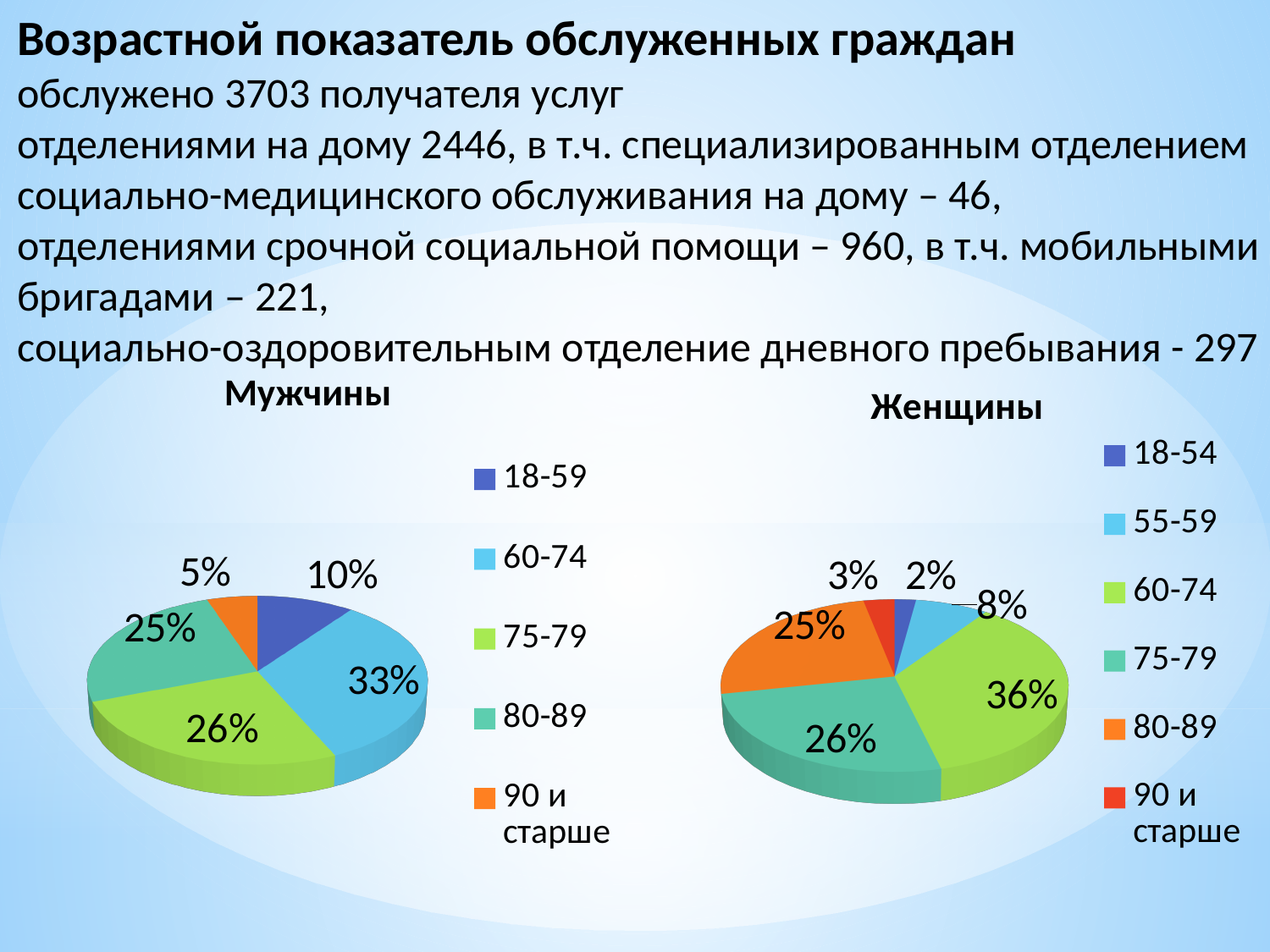
How many entries does the legend of the "Мужчины" pie chart list? 5 In the "Мужчины" pie chart, what is the difference between the shares for 60-74 and 18-59? 23% In the "Женщины" pie chart, which age group has the smallest share? 18-54 In the "Женщины" pie chart, what colour is the slice for "90 и старше"? Red In the "Мужчины" pie chart, what share is shown for the 60-74 age group? 33% In the "Женщины" pie chart, what share is shown for the 60-74 age group? 36% How many slices does the "Женщины" pie chart have? 6 In the "Женщины" pie chart, which is larger: the share for 75-79 or the share for 80-89? 75-79 In the "Женщины" pie chart, what share is shown for the 55-59 age group? 8% What type of chart is used for "Мужчины" and "Женщины"? Pie chart In the "Мужчины" pie chart, which age group has the largest share? 60-74 In the "Мужчины" pie chart, what share is shown for the "90 и старше" group? 5%